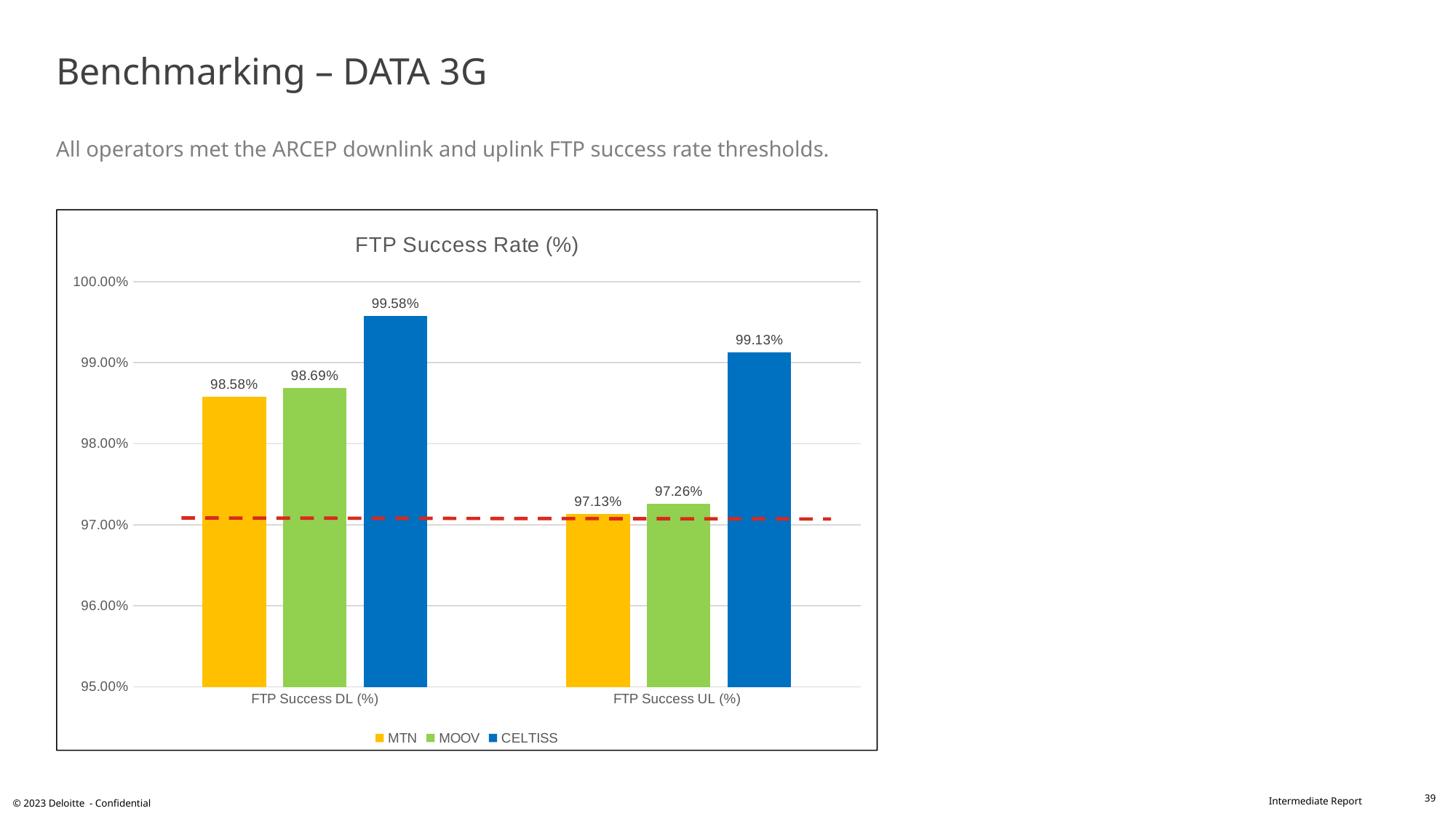
What is the FTP Success UL (%) value for MTN? 97.13% How many series does the legend list? 3 What is the difference between CELTISS and MTN for FTP Success DL (%)? 1.00% Which is larger: CELTISS's FTP Success DL (%) or CELTISS's FTP Success UL (%)? FTP Success DL (%) What is the difference between MOOV and MTN for FTP Success UL (%)? 0.13% What is the FTP Success DL (%) value for MOOV? 98.69% Is the FTP Success UL (%) value for CELTISS greater or less than 99.00%? greater Which operator has the highest FTP Success UL (%)? CELTISS What kind of chart is shown on the slide? Bar chart Which operator has the lowest FTP Success DL (%)? MTN What is the title of the chart? FTP Success Rate (%) What is the FTP Success DL (%) value for CELTISS? 99.58%